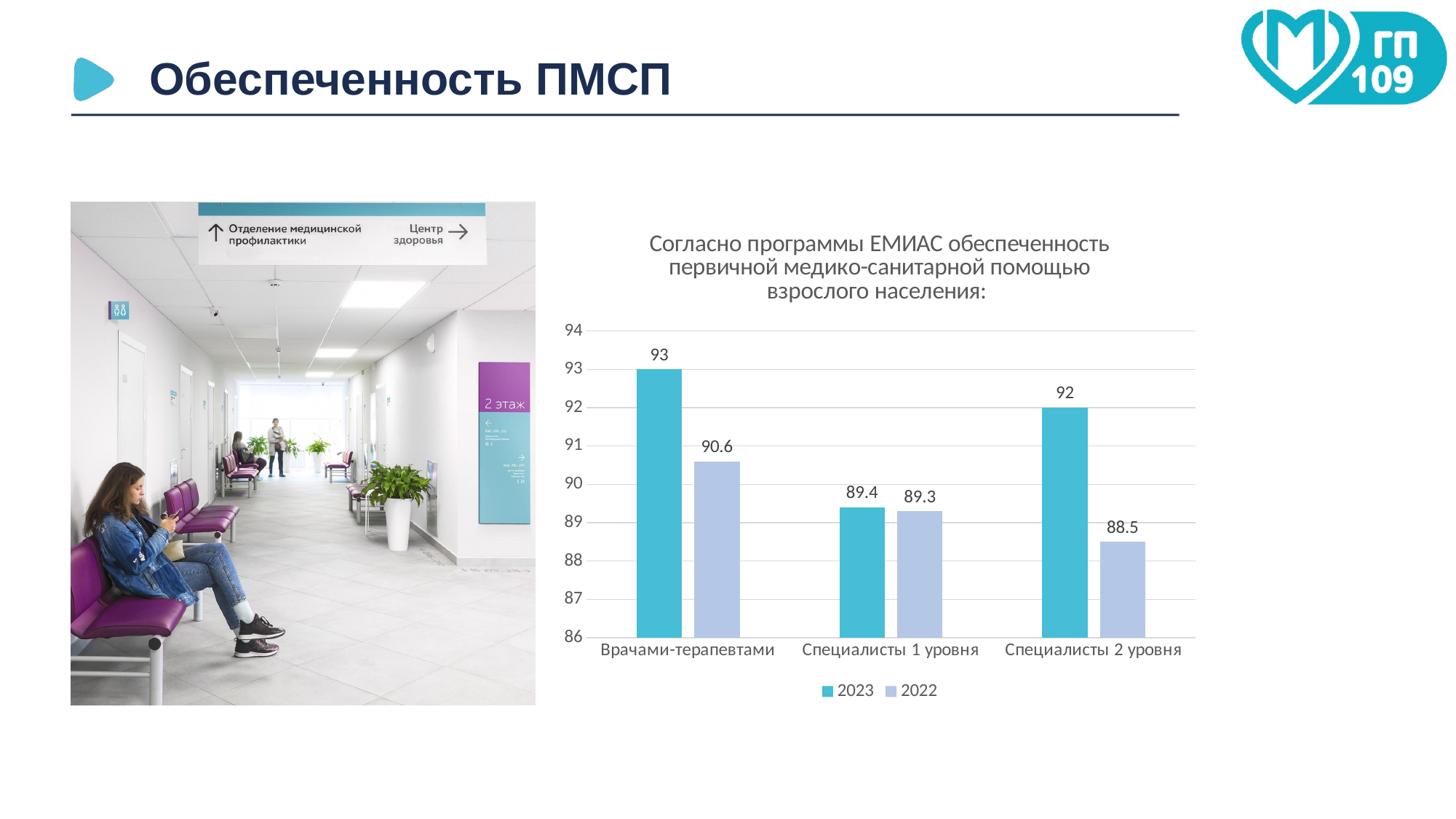
How many series does the chart legend list? 2 What is the value for Специалисты 2 уровня in the 2022 series? 88.5 Is the 2022 value for Врачами-терапевтами greater or less than 90? greater Which category has the highest value in the 2023 series? Врачами-терапевтами What is the value for Врачами-терапевтами in the 2023 series? 93 Which category has the lowest value in the 2022 series? Специалисты 2 уровня What kind of chart is shown on the slide? Bar chart How many categories are shown on the x axis of the chart? 3 What is the difference between the 2023 and 2022 values for Специалисты 2 уровня? 3.5 What is the value for Специалисты 1 уровня in the 2023 series? 89.4 Which is larger for Специалисты 2 уровня: the 2023 value or the 2022 value? 2023 What is the difference between the 2023 and 2022 values for Врачами-терапевтами? 2.4